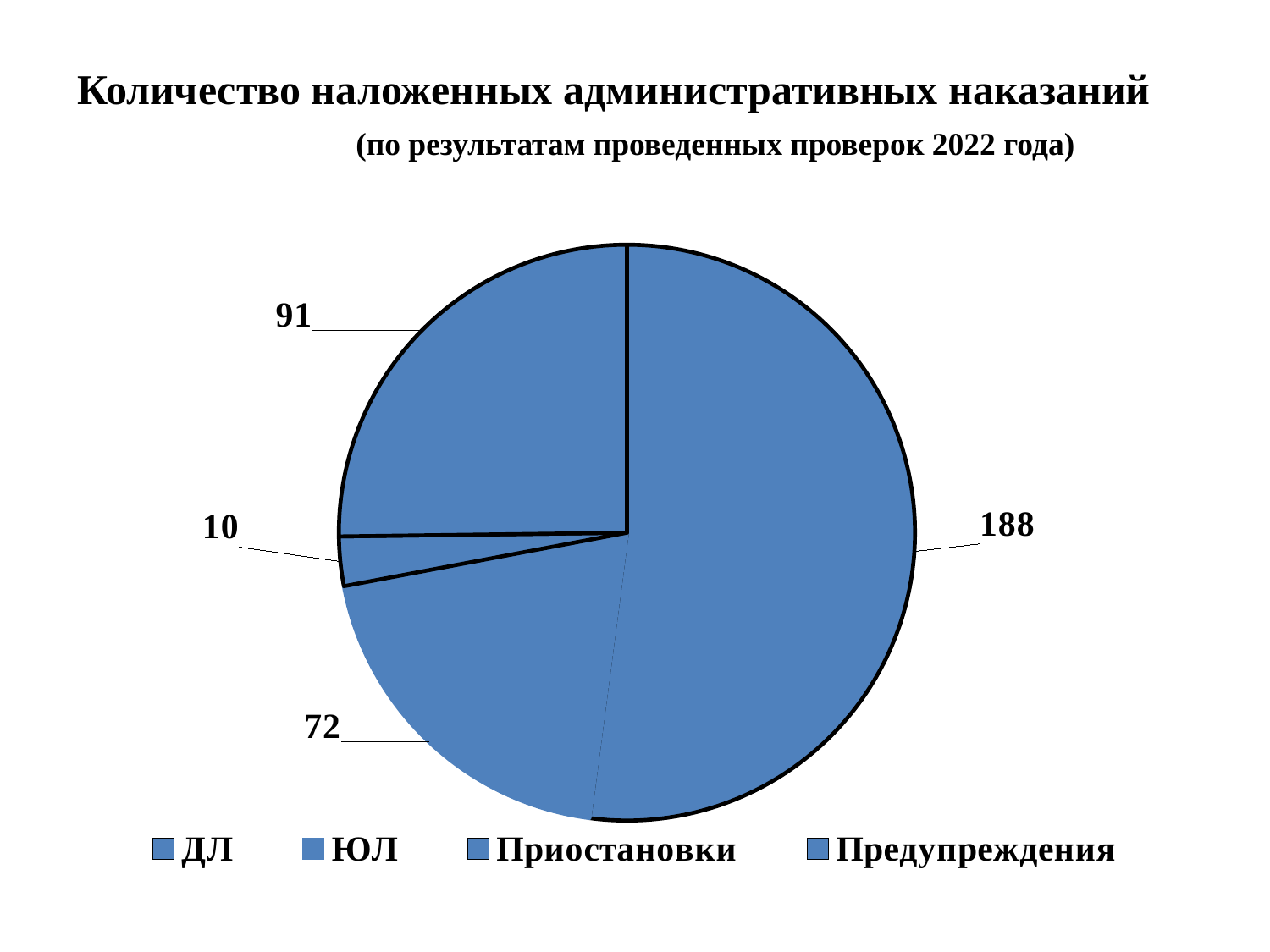
What is the smallest value labelled on the pie chart? 10 What is the title of the chart on the slide? Количество наложенных административных наказаний What is the difference between the slices labelled 91 and 72? 19 What is the difference between the slice labelled 72 and the slice labelled 10? 62 What is the total of all the values labelled on the pie chart? 361 What is the largest value labelled on the pie chart? 188 How many slices does the pie chart have? 4 Which is larger, the slice labelled 72 or the slice labelled 91? 91 How many entries does the legend of the pie chart list? 4 What is the difference between the largest slice (188) and the slice labelled 91? 97 What type of chart is shown on the slide? pie chart Which year do the inspection results in the chart subtitle refer to? 2022